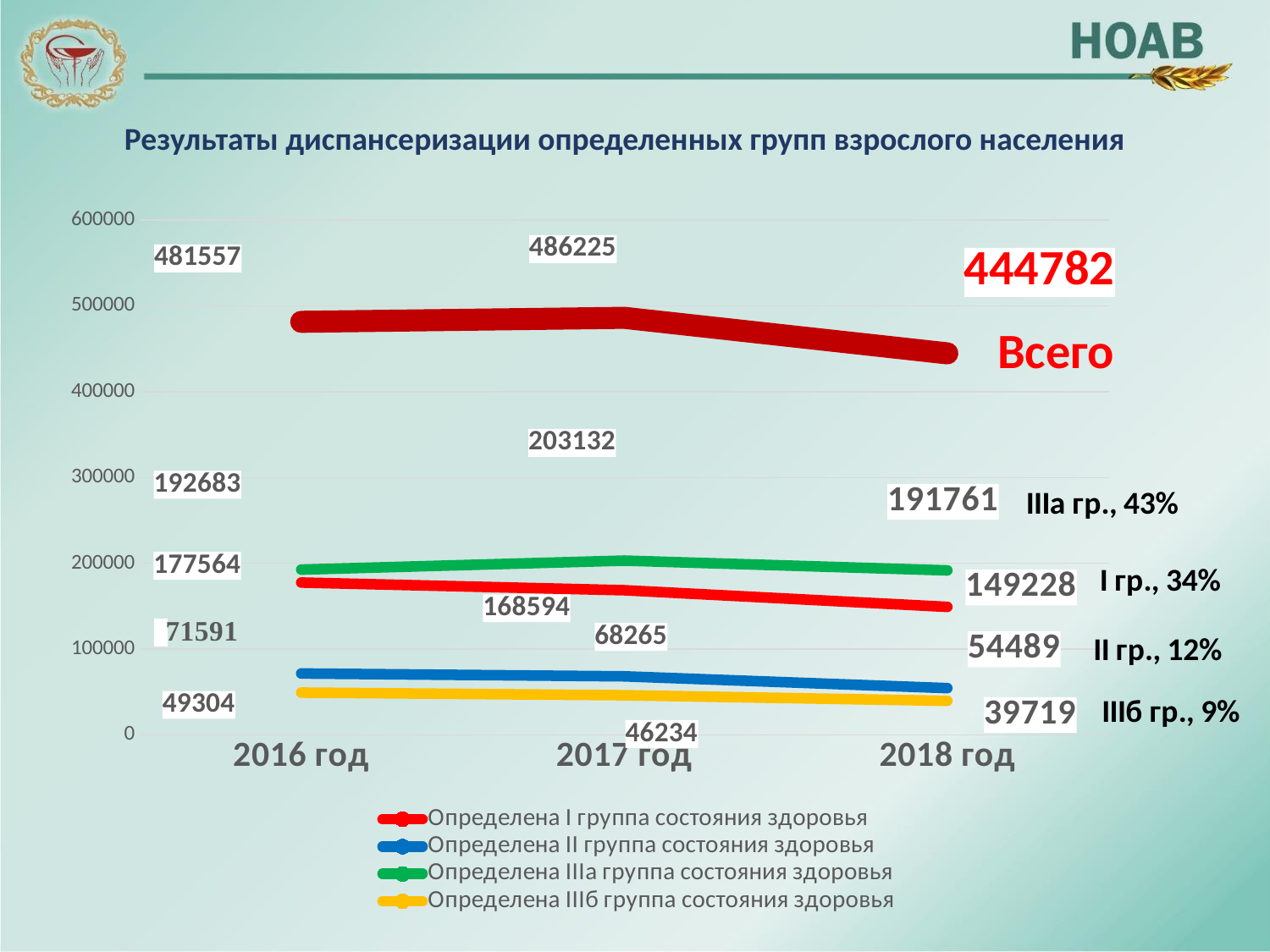
What is the value for 'Определена IIIа группа состояния здоровья' in 2017 год? 203132 What is the difference between the 'Всего' values for 2017 год and 2018 год? 41443 In which year is the 'Всего' (total) value highest? 2017 год What is the value for 'Определена I группа состояния здоровья' in 2018 год? 149228 Does the value for 'Определена I группа состояния здоровья' rise or fall from 2016 год to 2018 год? fall What is the 'Всего' (total) value for 2016 год? 481557 By how much did the value for 'Определена I группа состояния здоровья' decrease from 2016 год to 2018 год? 28336 What kind of chart is shown on the slide? line chart How many series does the legend list? 4 In which year is the value for 'Определена IIIб группа состояния здоровья' lowest? 2018 год How many years are shown on the x axis? 3 In 2017 год, which is larger: the value for 'Определена IIIа группа состояния здоровья' or 'Определена I группа состояния здоровья'? Определена IIIа группа состояния здоровья